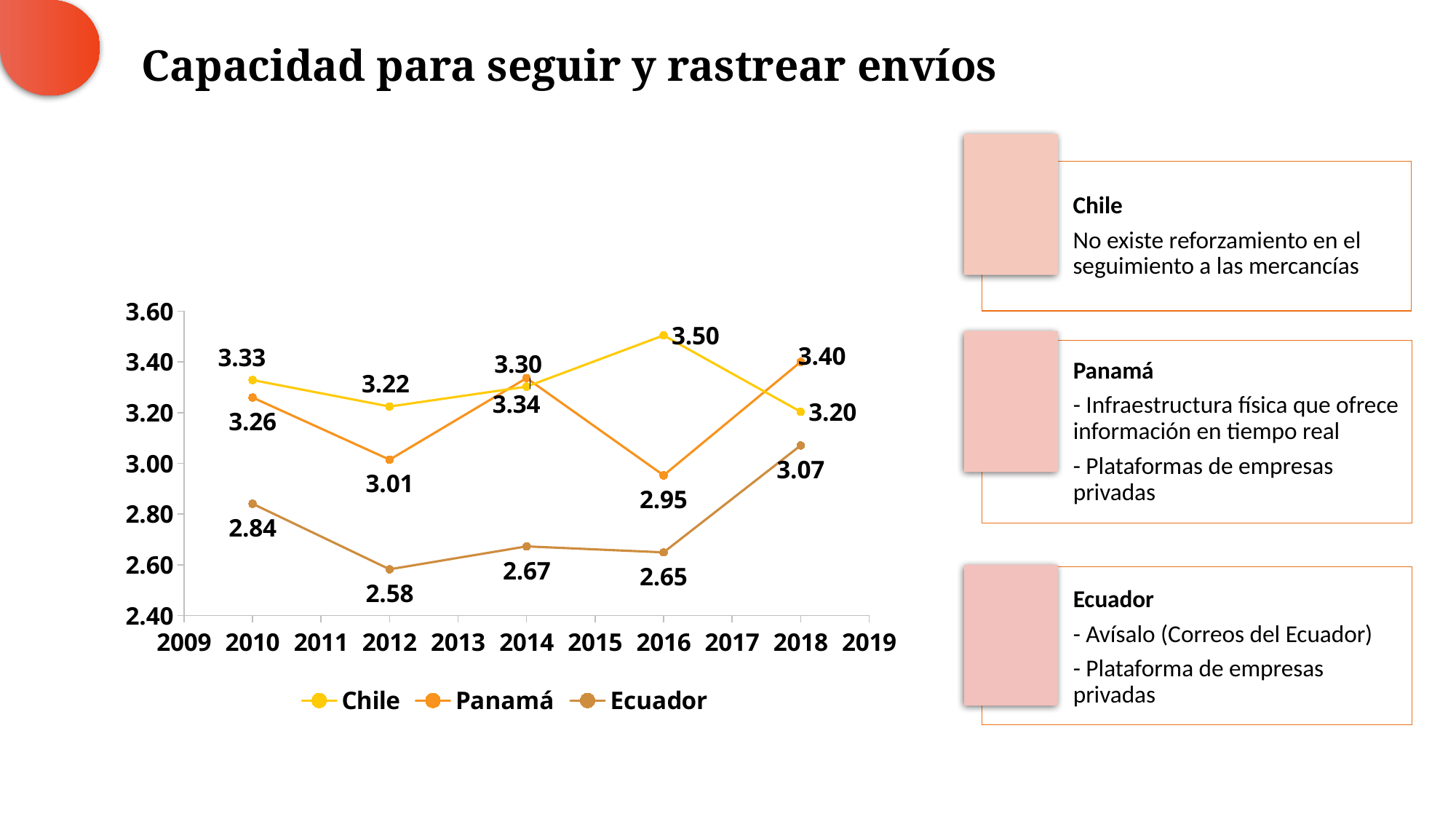
In which year does Ecuador have its lowest value? 2012 What is the title of the slide containing the chart? Capacidad para seguir y rastrear envíos Does the Ecuador series rise or fall from 2016 to 2018? rise What is the value for Ecuador in 2018? 3.07 How many data points are plotted for the Ecuador series? 5 What is the value for Panamá in 2012? 3.01 What type of chart is shown on the slide? line chart In which year does Chile have its highest value? 2016 Which is larger in 2010, the value for Chile or the value for Panamá? Chile How many series does the legend list? 3 What is the difference between the Panamá value in 2018 and the Panamá value in 2016? 0.45 What is the value for Chile in 2016? 3.50